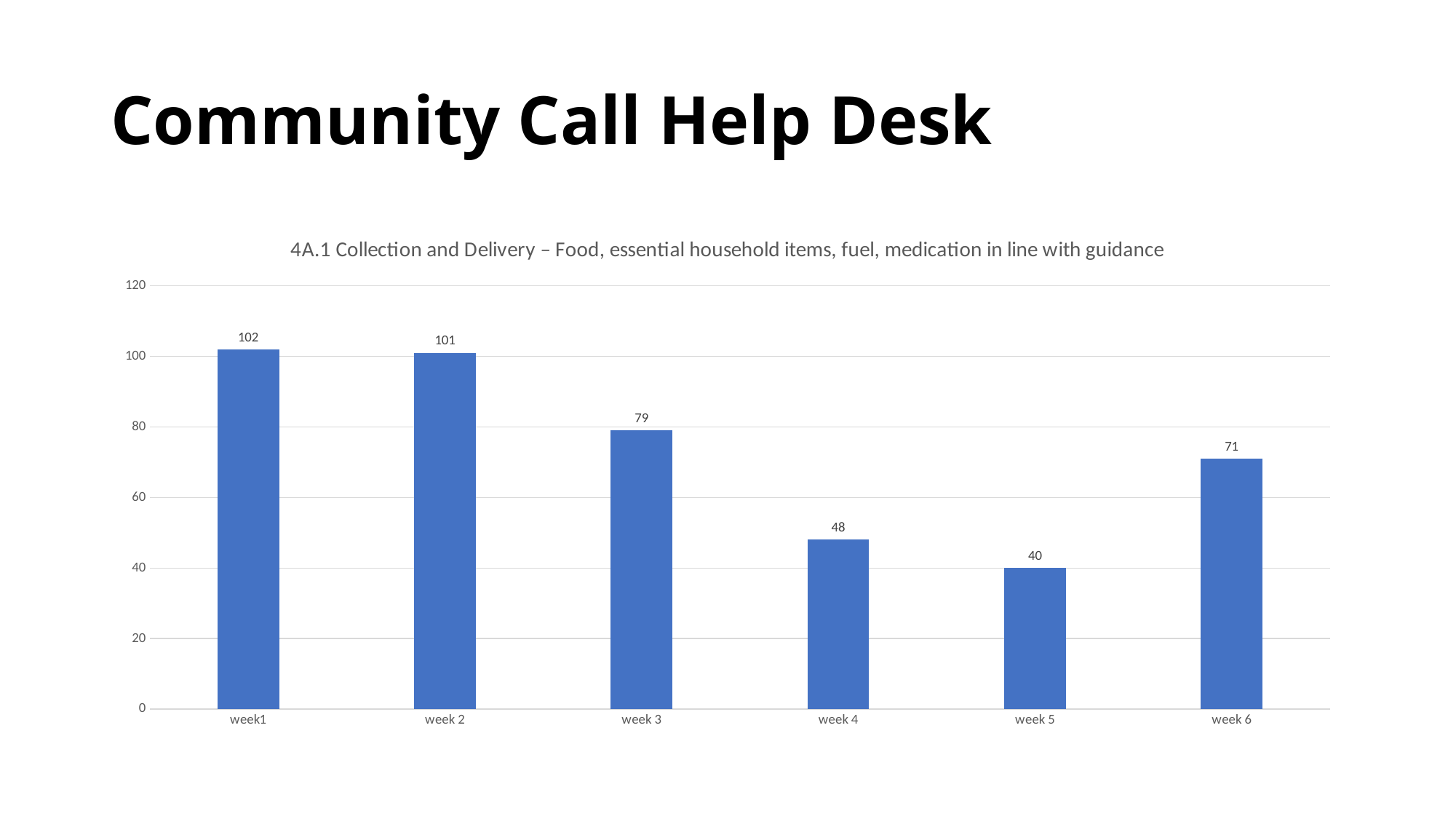
Is the value for week 2 greater or less than 80? greater What is the value for week 3? 79 What is the value for week 5? 40 What is the difference between the values for week1 and week 6? 31 Which week has the lowest value? week 5 Which week has the highest value? week1 What is the title of the chart? 4A.1 Collection and Delivery – Food, essential household items, fuel, medication in line with guidance How many weeks are shown on the x axis? 6 What is the value for week 6? 71 Which is larger, the value for week 4 or the value for week 6? week 6 What kind of chart is shown on the slide? bar chart What is the difference between the values for week 3 and week 4? 31